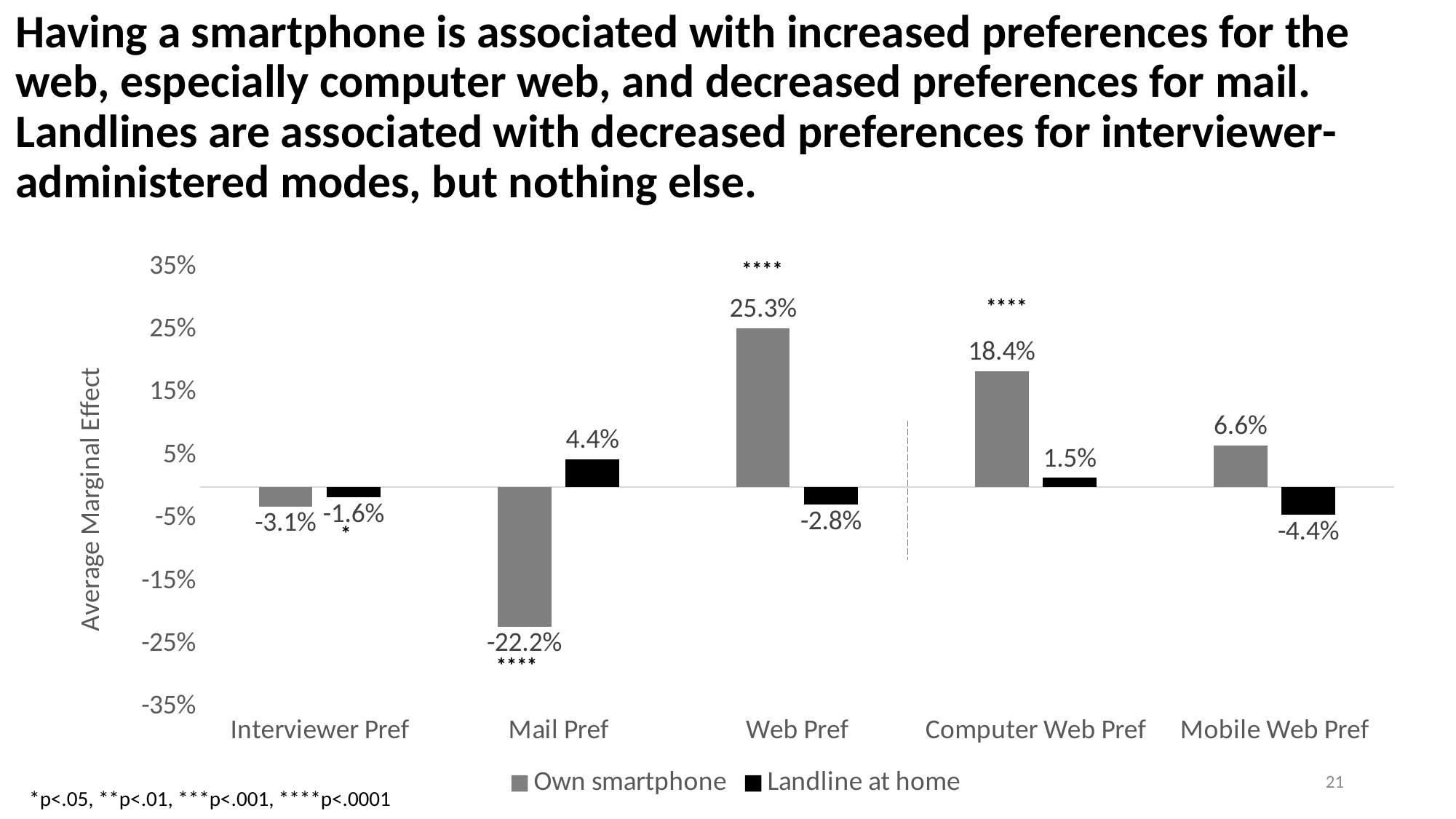
What is the average marginal effect of having a landline at home on Mail Pref? 4.4% Which category has the lowest value for the Own smartphone series? Mail Pref What is the value for Own smartphone in the Mail Pref category? -22.2% Which is larger for Computer Web Pref: the Own smartphone value or the Landline at home value? Own smartphone What is the value for Landline at home in the Mobile Web Pref category? -4.4% What is the label of the vertical axis? Average Marginal Effect What is the difference between the Own smartphone values for Web Pref and Computer Web Pref? 6.9% How many preference categories are shown on the x axis? 5 What is the average marginal effect of owning a smartphone on Web Pref? 25.3% How many series does the legend list? 2 What kind of chart is shown on the slide? Bar chart Which category has the highest value for the Own smartphone series? Web Pref